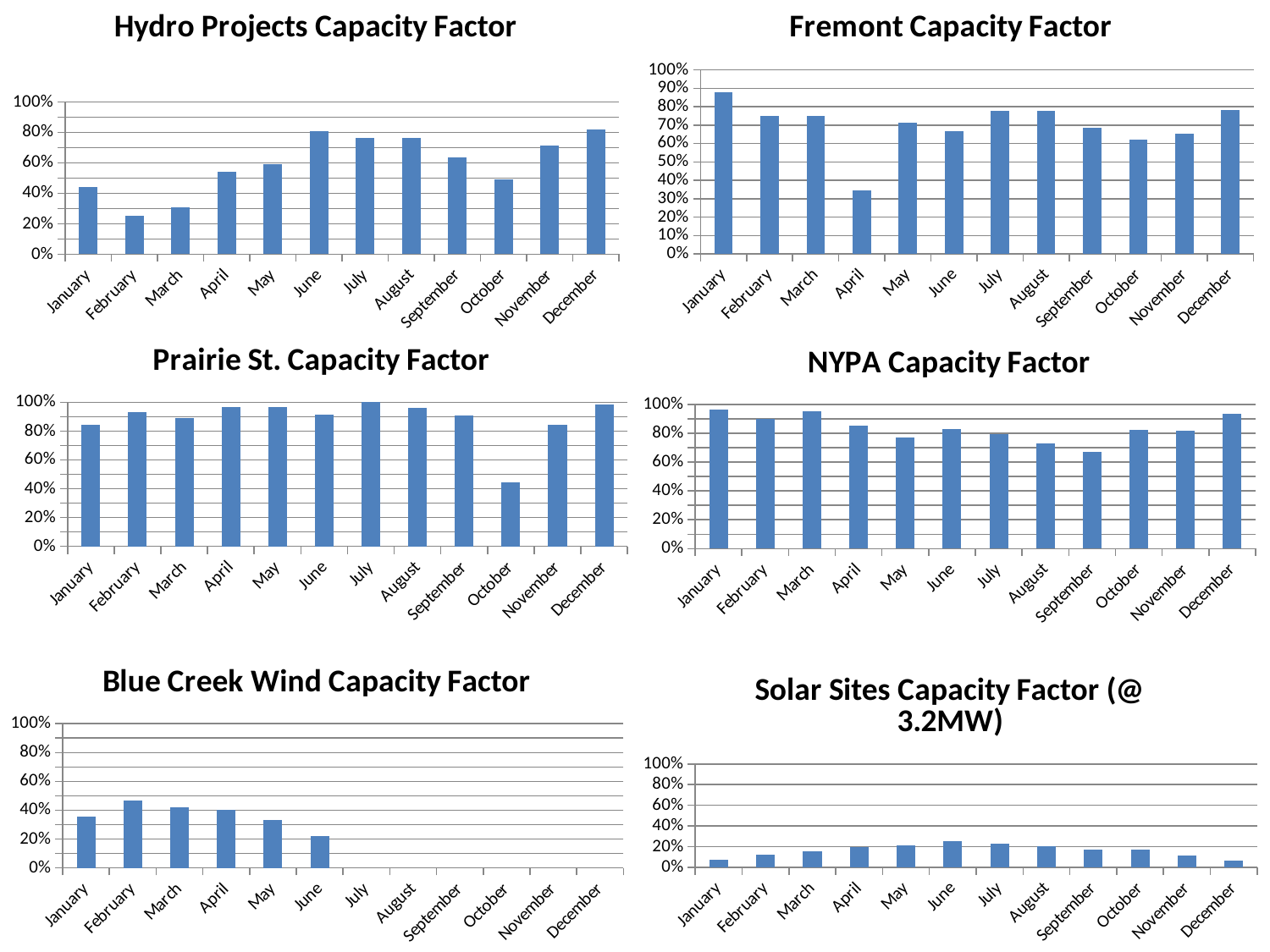
In the Hydro Projects Capacity Factor chart, is the value for June greater or less than 60%? greater In the Fremont Capacity Factor chart, which month has the highest capacity factor? January In the Solar Sites Capacity Factor (@ 3.2MW) chart, is the value for January greater or less than 20%? less In the Blue Creek Wind Capacity Factor chart, which month has the highest capacity factor? February What kind of chart is the Prairie St. Capacity Factor chart? bar chart In the Fremont Capacity Factor chart, which month has the lowest capacity factor? April In the Blue Creek Wind Capacity Factor chart, how many months have a bar plotted? 6 In the Fremont Capacity Factor chart, is the value for April greater or less than 40%? less In the NYPA Capacity Factor chart, which month has the lowest capacity factor? September In the Prairie St. Capacity Factor chart, which month has the lowest capacity factor? October In the Blue Creek Wind Capacity Factor chart, do the values rise or fall from February to June? fall